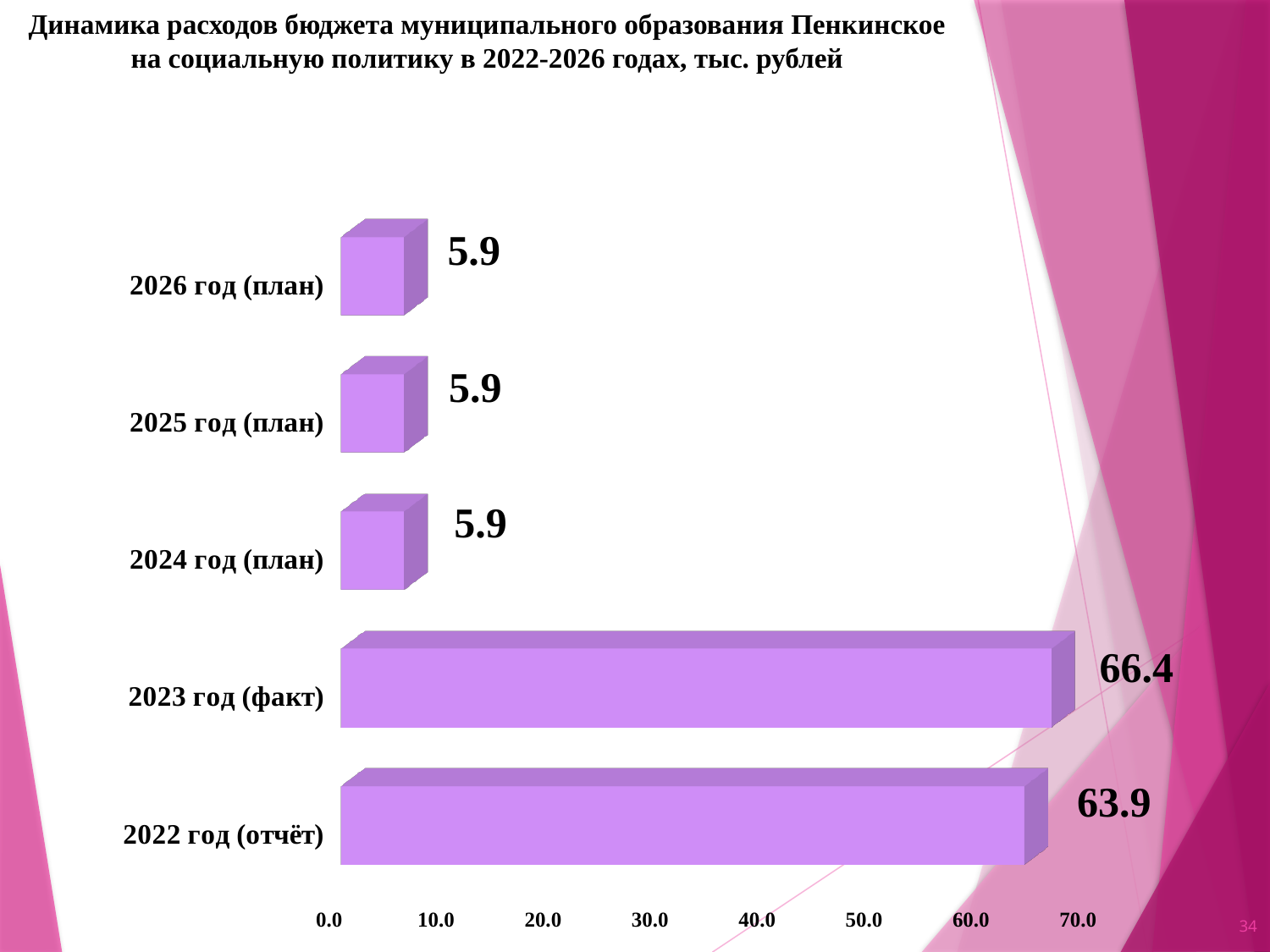
Is the value for 2026 год (план) greater or less than 10.0? less Is the value for 2022 год (отчёт) greater or less than 60.0? greater What is the value for 2024 год (план)? 5.9 How many categories are shown in the chart? 5 What is the unit of measurement stated in the chart title? тыс. рублей What is the difference between the values for 2023 год (факт) and 2024 год (план)? 60.5 Which is larger, the value for 2022 год (отчёт) or the value for 2025 год (план)? 2022 год (отчёт) What is the value for 2023 год (факт)? 66.4 Which category has the highest value? 2023 год (факт) What is the difference between the values for 2023 год (факт) and 2022 год (отчёт)? 2.5 What kind of chart is shown on the slide? bar chart What is the value for 2022 год (отчёт)? 63.9